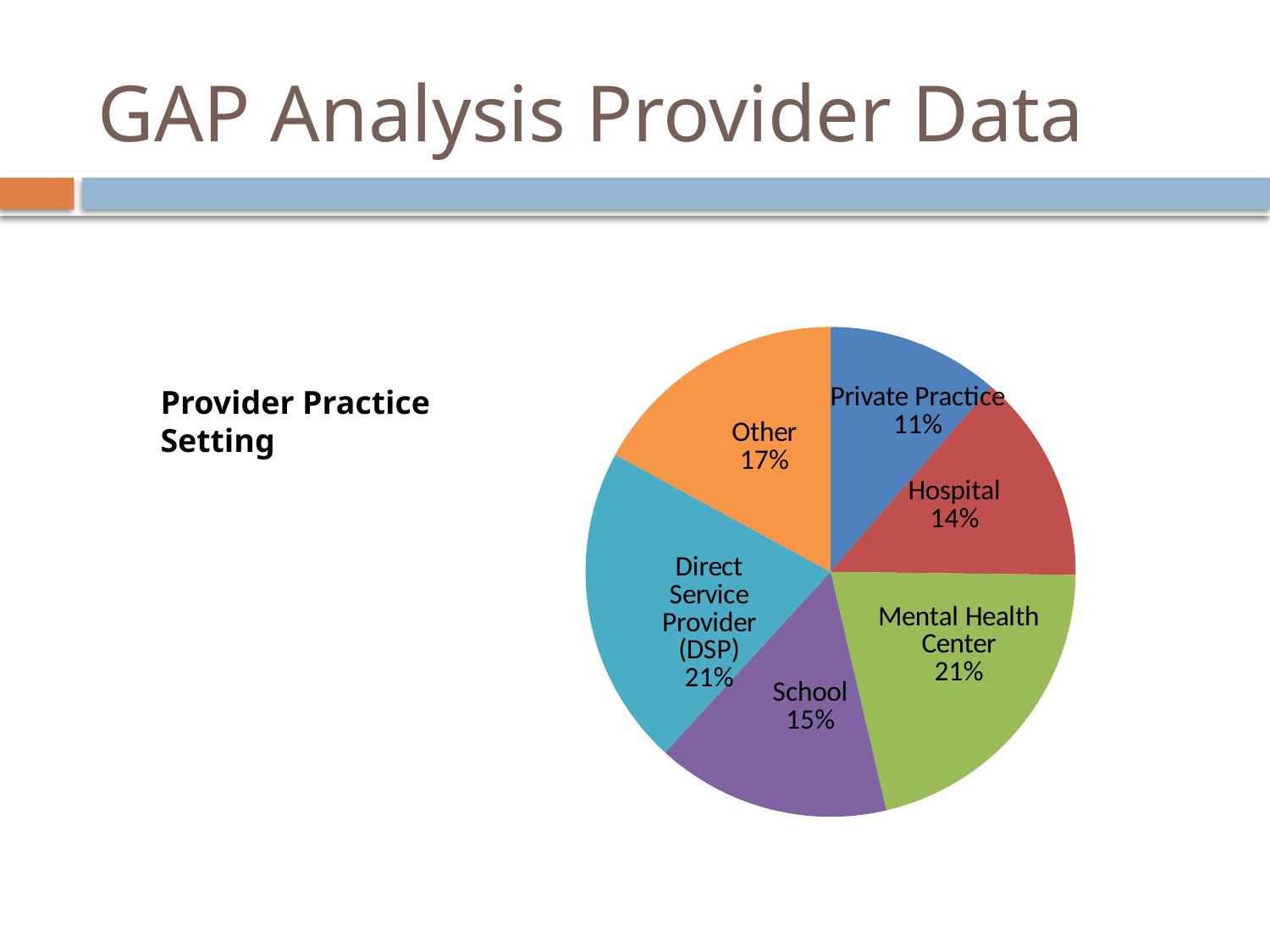
What is the value shown for Private Practice? 11% What is the value shown for Direct Service Provider (DSP)? 21% What is the difference between the Other share and the Private Practice share? 6% What share of the pie does Hospital represent? 14% What percentage is shown for School? 15% What share of the pie does Other represent? 17% Which is larger, the share for School or the share for Other? Other What kind of chart is shown on the slide? pie chart What is the title of the slide containing the pie chart? GAP Analysis Provider Data How many categories are shown in the pie chart? 6 Which category has the smallest slice of the pie? Private Practice What is the difference between the Mental Health Center share and the Hospital share? 7%